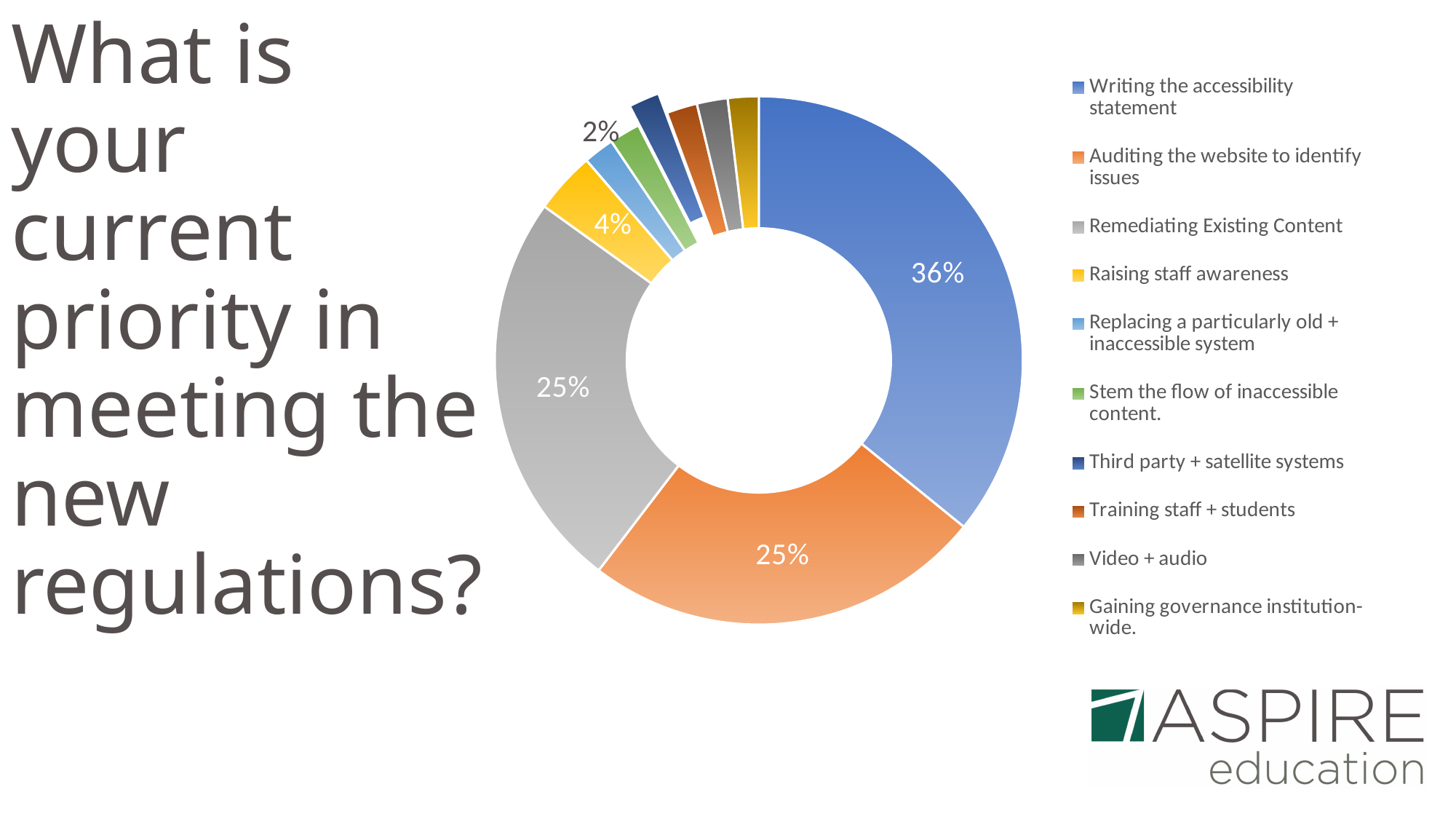
Which priority has the largest share of the chart? Writing the accessibility statement What percentage is shown for 'Raising staff awareness'? 4% What percentage is shown for 'Remediating Existing Content'? 25% What is the difference in percentage points between 'Raising staff awareness' and 'Replacing a particularly old + inaccessible system'? 2% What is the difference in percentage points between 'Writing the accessibility statement' and 'Remediating Existing Content'? 11% What colour is the slice for 'Raising staff awareness'? yellow What percentage is shown for 'Replacing a particularly old + inaccessible system'? 2% How many categories does the legend list? 10 What kind of chart is shown on the slide? doughnut chart What percentage is shown for 'Auditing the website to identify issues'? 25% Which is larger: the share for 'Writing the accessibility statement' or the share for 'Auditing the website to identify issues'? Writing the accessibility statement What percentage of respondents chose 'Writing the accessibility statement' as their current priority? 36%